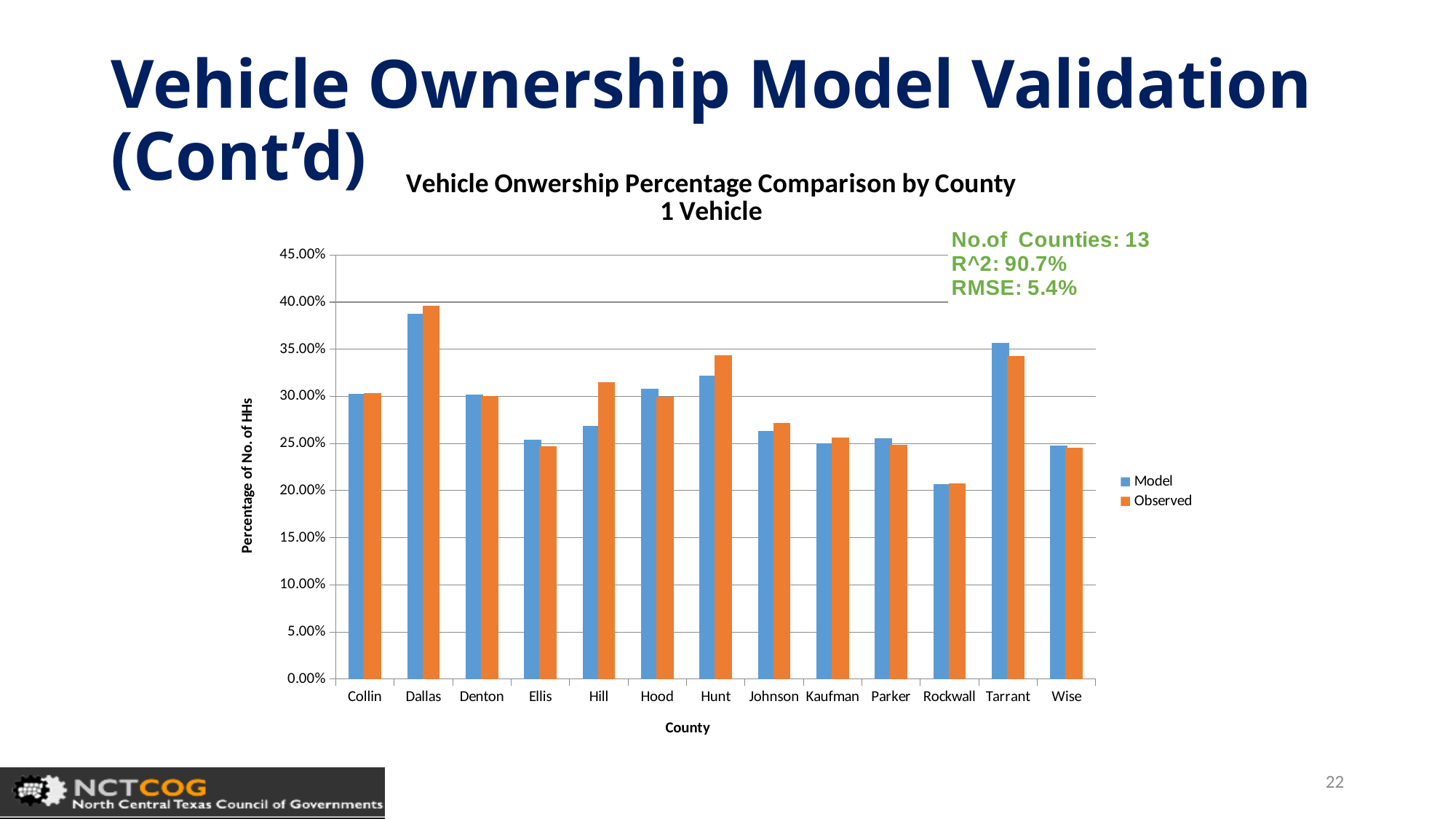
How many series does the chart legend list? 2 For Tarrant, which is larger: the Model value or the Observed value? Model Is the Observed value for Hill greater or less than 30.00%? greater What kind of chart is shown on the slide? Bar chart For Hill, which is larger: the Model value or the Observed value? Observed Is the Observed value for Dallas greater or less than 35.00%? greater Is the Model value for Rockwall greater or less than 25.00%? less What is the label of the y axis of the chart? Percentage of No. of HHs Which county has the highest Observed value? Dallas How many counties are shown on the x axis of the chart? 13 Which county has the lowest Model value? Rockwall What R^2 value is stated on the chart? 90.7%